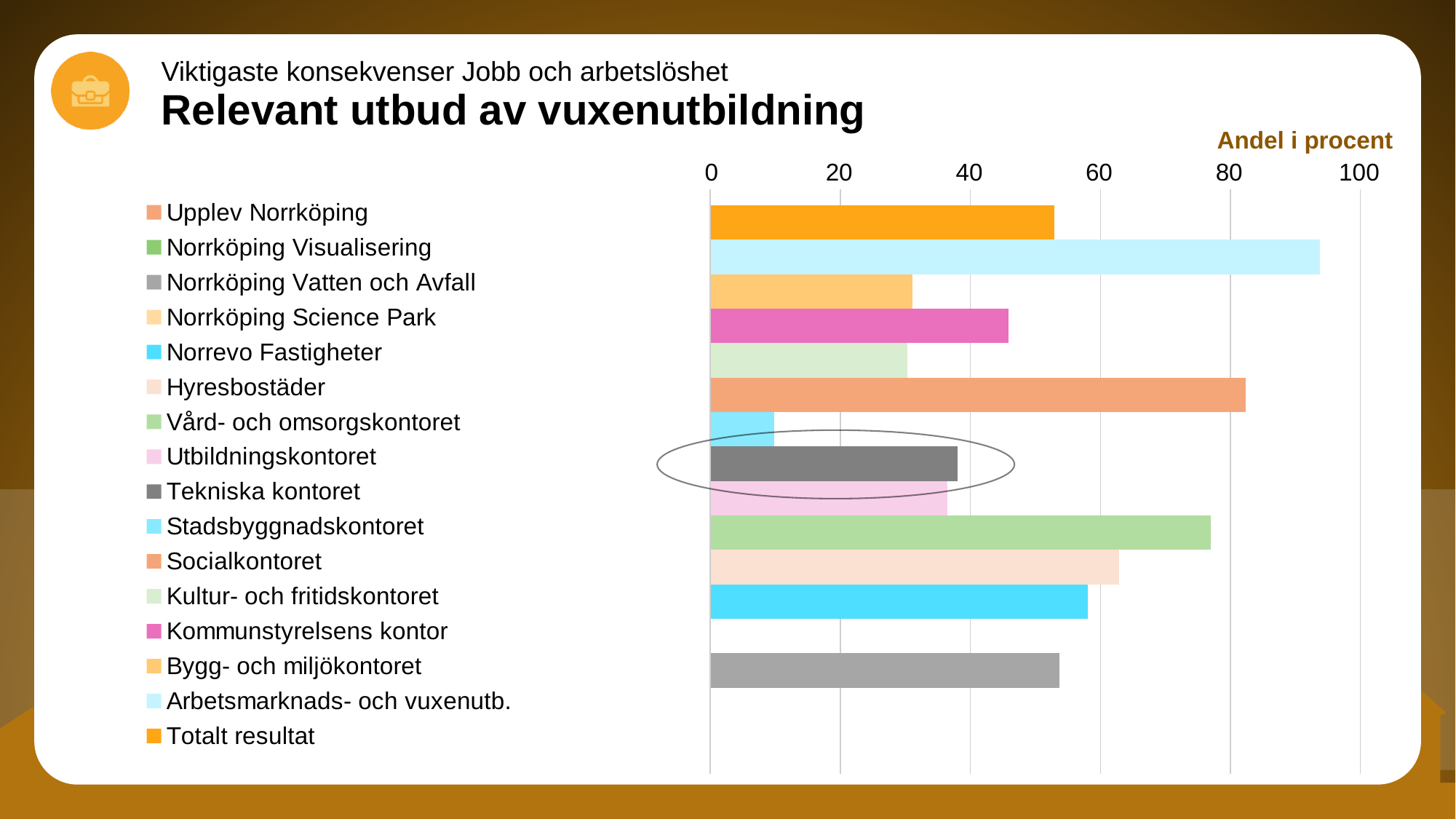
Is the value for Arbetsmarknads- och vuxenutb. greater or less than 80? greater Which is larger, the value for Kommunstyrelsens kontor or the value for Kultur- och fritidskontoret? Kommunstyrelsens kontor Which category has the lowest plotted value in the chart? Stadsbyggnadskontoret Is the value for Vård- och omsorgskontoret greater or less than 60? greater How many entries does the legend list? 16 What kind of chart is shown on the slide? bar chart Is the value for Totalt resultat greater or less than 40? greater Which category has the highest value in the chart? Arbetsmarknads- och vuxenutb. Which is larger, the value for Socialkontoret or the value for Vård- och omsorgskontoret? Socialkontoret What is the label shown above the value axis of the chart? Andel i procent